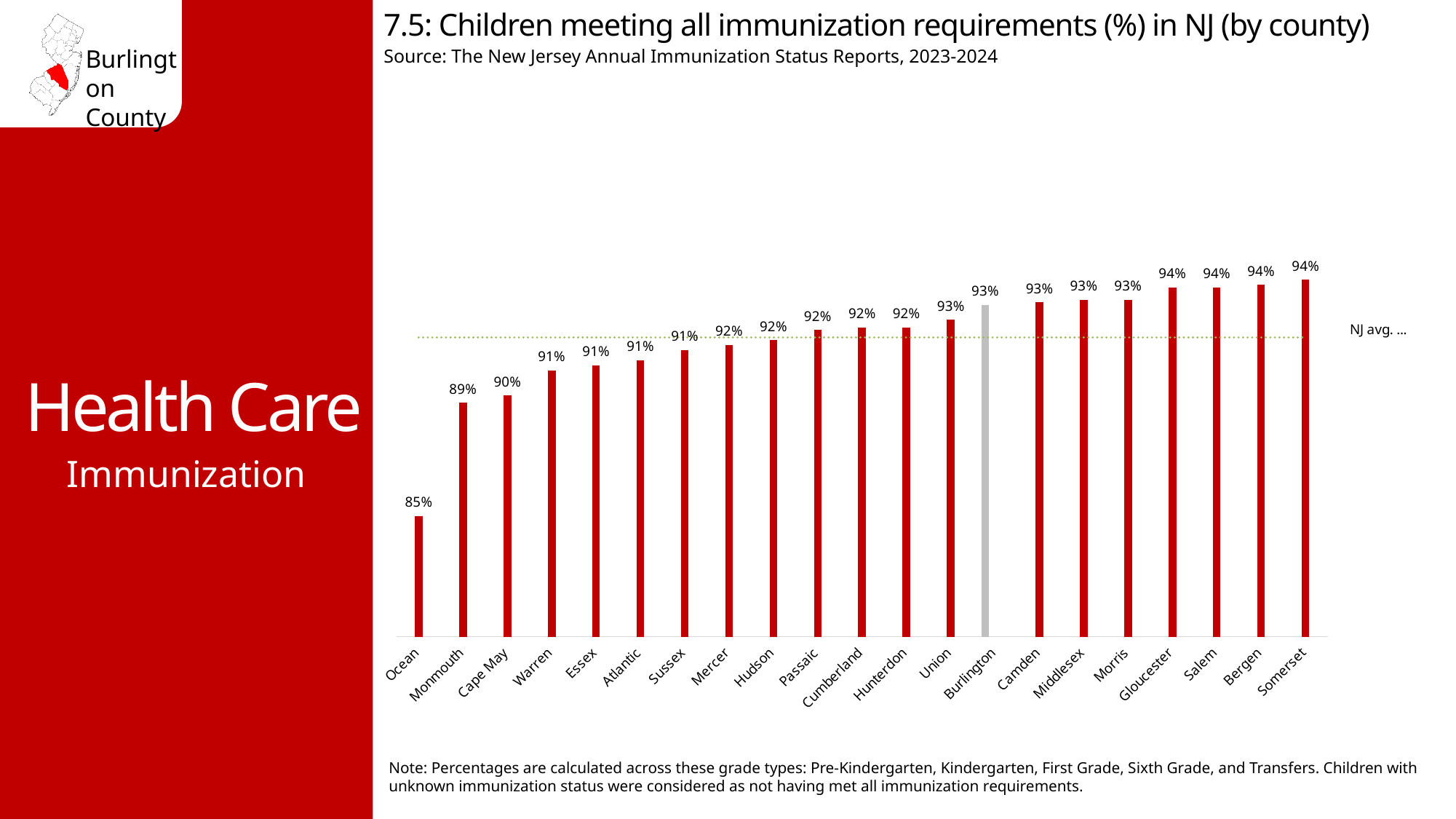
Which has a higher value, Monmouth or Cape May? Cape May What is the value shown for Burlington County? 93% What is the difference in percentage points between Somerset and Ocean? 9 percentage points Which county's bar is coloured grey instead of red? Burlington Which county has the lowest percentage of children meeting all immunization requirements? Ocean What is the value shown for Cape May? 90% Do the values rise or fall moving from left to right along the x axis? Rise What is the difference in percentage points between Burlington and Ocean? 8 percentage points What kind of chart is shown on the slide? Bar chart How many counties are shown on the chart? 21 What is the value shown for Somerset? 94% What percentage of children in Ocean County met all immunization requirements? 85%